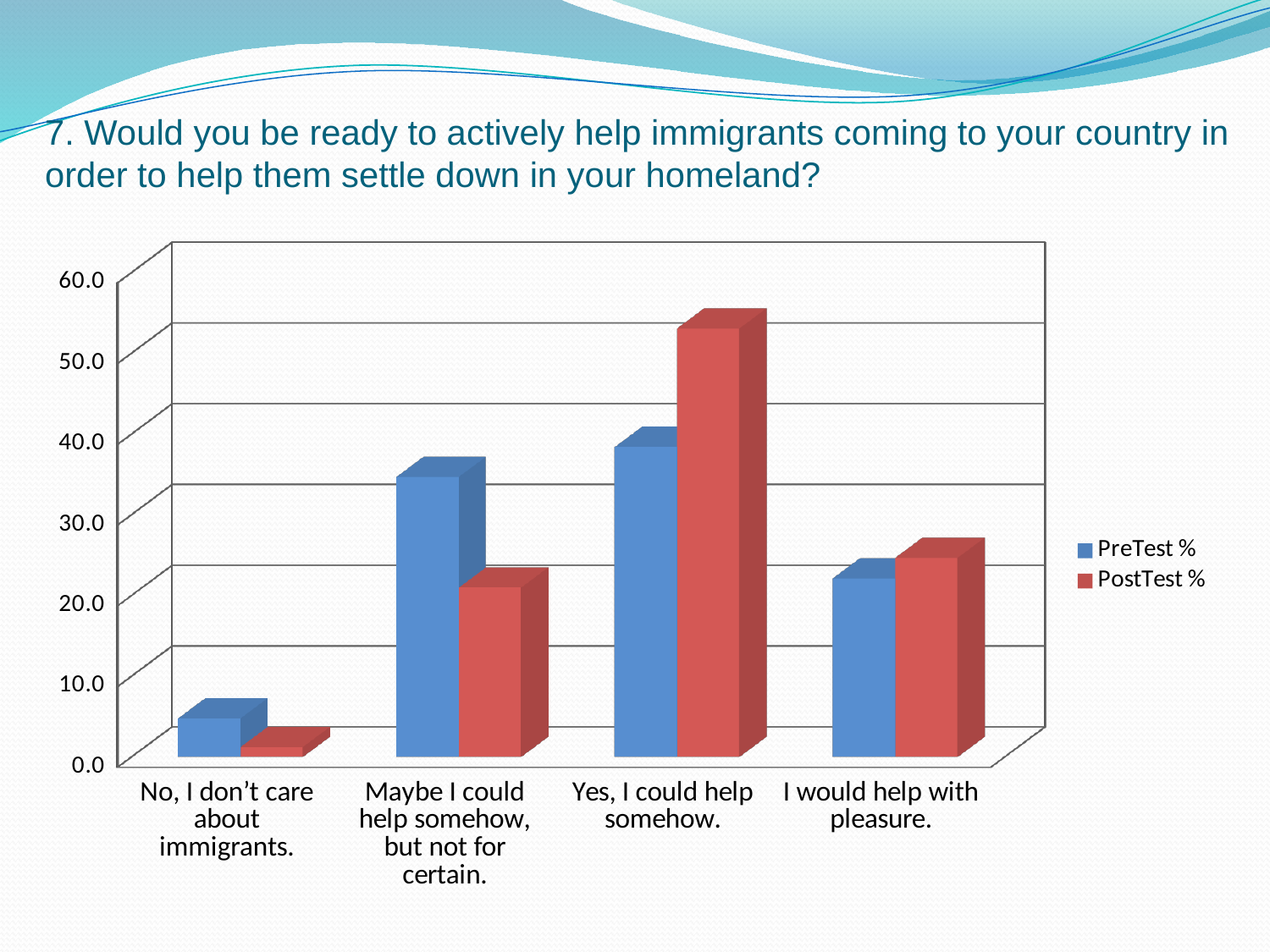
Which category has the lowest PreTest % value? No, I don't care about immigrants. Is the PostTest % value for "No, I don't care about immigrants." greater or less than 10.0? less Which category has the lowest PostTest % value? No, I don't care about immigrants. Which category has the highest PostTest % value? Yes, I could help somehow. Is the PreTest % value for "Maybe I could help somehow, but not for certain." greater or less than 30.0? greater How many answer categories are shown on the x axis? 4 Is the PostTest % value for "Yes, I could help somehow." greater or less than 40.0? greater What colour are the PostTest % bars? red For "Yes, I could help somehow.", which is larger: PreTest % or PostTest %? PostTest % For "Maybe I could help somehow, but not for certain.", which is larger: PreTest % or PostTest %? PreTest % What kind of chart is shown on the slide? bar chart How many series does the legend list? 2